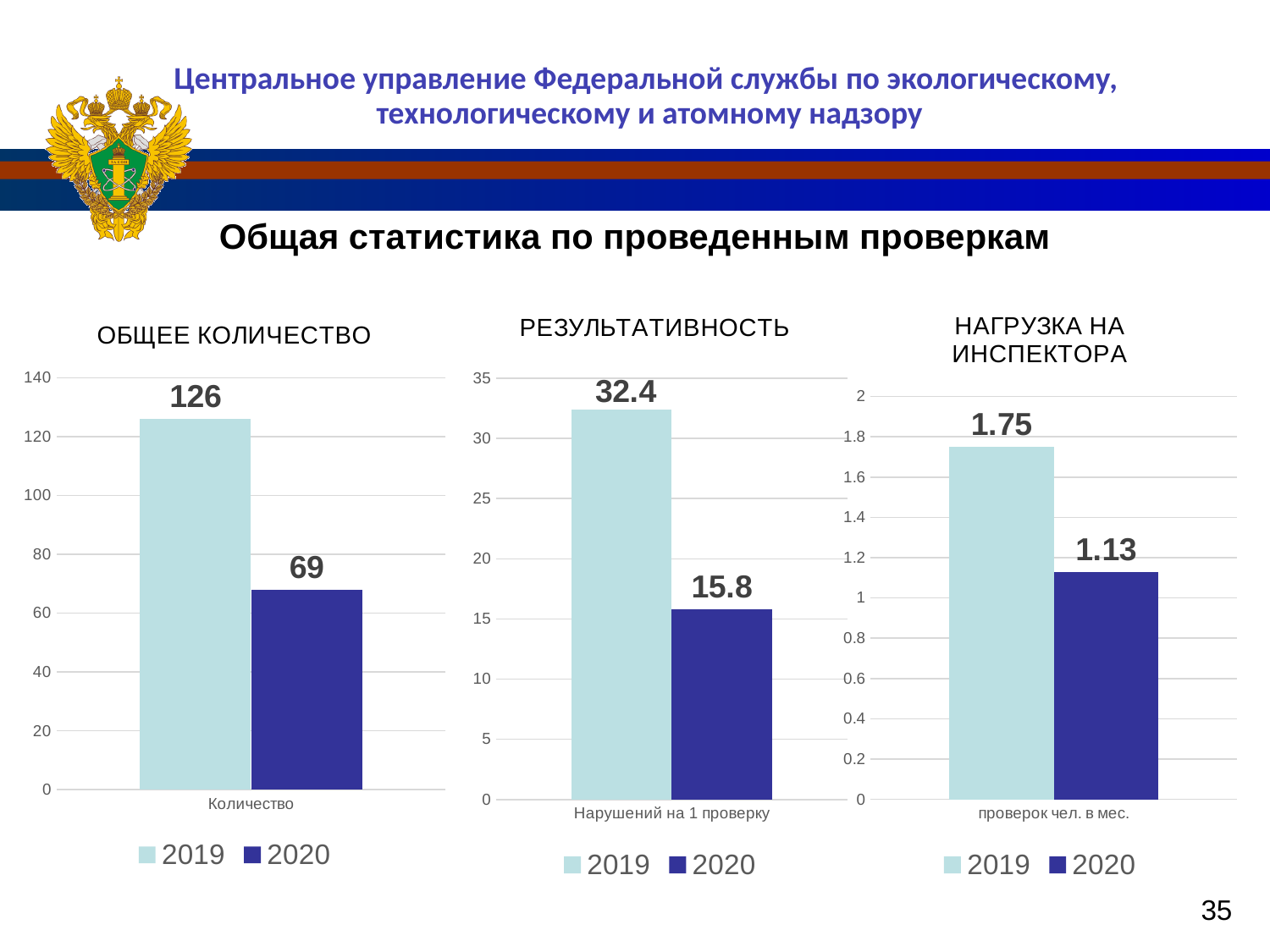
In the chart titled "ОБЩЕЕ КОЛИЧЕСТВО", what is the value for 2019? 126 In the chart titled "НАГРУЗКА НА ИНСПЕКТОРА", what is the value for 2020? 1.13 In the chart titled "РЕЗУЛЬТАТИВНОСТЬ", which series has the higher value, 2019 or 2020? 2019 How many series does the legend of the chart titled "ОБЩЕЕ КОЛИЧЕСТВО" list? 2 In the chart titled "НАГРУЗКА НА ИНСПЕКТОРА", what is the difference between the 2019 and 2020 values? 0.62 In the chart titled "НАГРУЗКА НА ИНСПЕКТОРА", what is the value for 2019? 1.75 In the chart titled "ОБЩЕЕ КОЛИЧЕСТВО", what is the difference between the 2019 and 2020 values? 57 In the chart titled "РЕЗУЛЬТАТИВНОСТЬ", what is the value for 2020? 15.8 In the chart titled "ОБЩЕЕ КОЛИЧЕСТВО", what is the value for 2020? 69 In the chart titled "ОБЩЕЕ КОЛИЧЕСТВО", is the value for 2020 greater or less than 80? less In the chart titled "РЕЗУЛЬТАТИВНОСТЬ", what is the value for 2019? 32.4 What kind of chart is the chart titled "РЕЗУЛЬТАТИВНОСТЬ"? Bar chart